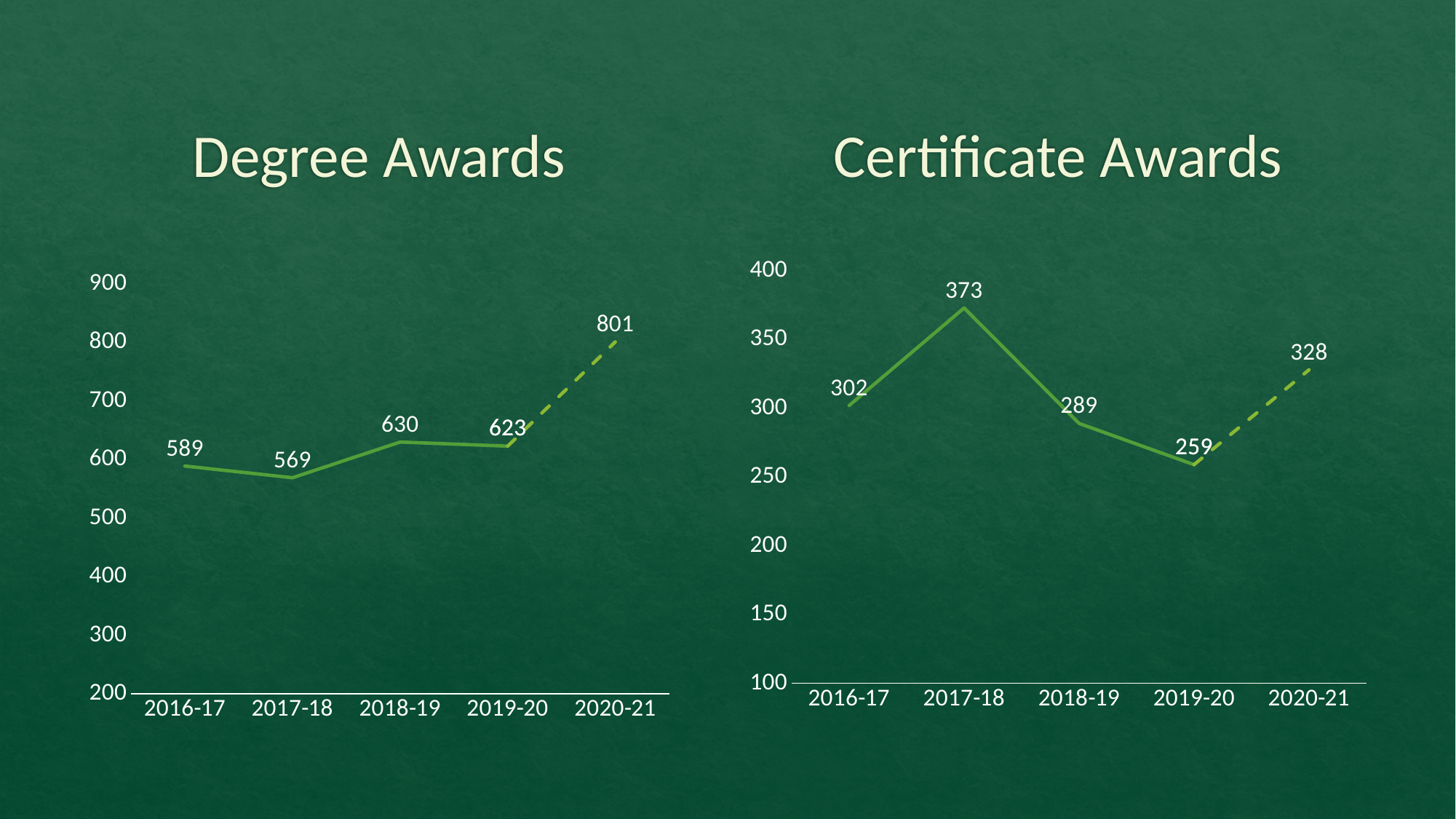
What kind of chart is the Certificate Awards chart? line chart In the Certificate Awards chart, which year has the lowest value? 2019-20 In the Certificate Awards chart, what is the difference between the values for 2017-18 and 2016-17? 71 In the Degree Awards chart, which year has the highest value? 2020-21 In the Certificate Awards chart, what is the value for 2017-18? 373 In the Degree Awards chart, what is the value for 2018-19? 630 In the Degree Awards chart, what is the difference between the values for 2020-21 and 2019-20? 178 In the Degree Awards chart, how is the line segment to 2020-21 drawn differently from the other segments? It is dashed In the Certificate Awards chart, is the value for 2020-21 greater or less than 300? greater How many years are plotted in the Degree Awards chart? 5 In the Degree Awards chart, which is larger, the value for 2016-17 or the value for 2017-18? 2016-17 In the Degree Awards chart, do the values rise or fall from 2019-20 to 2020-21? rise